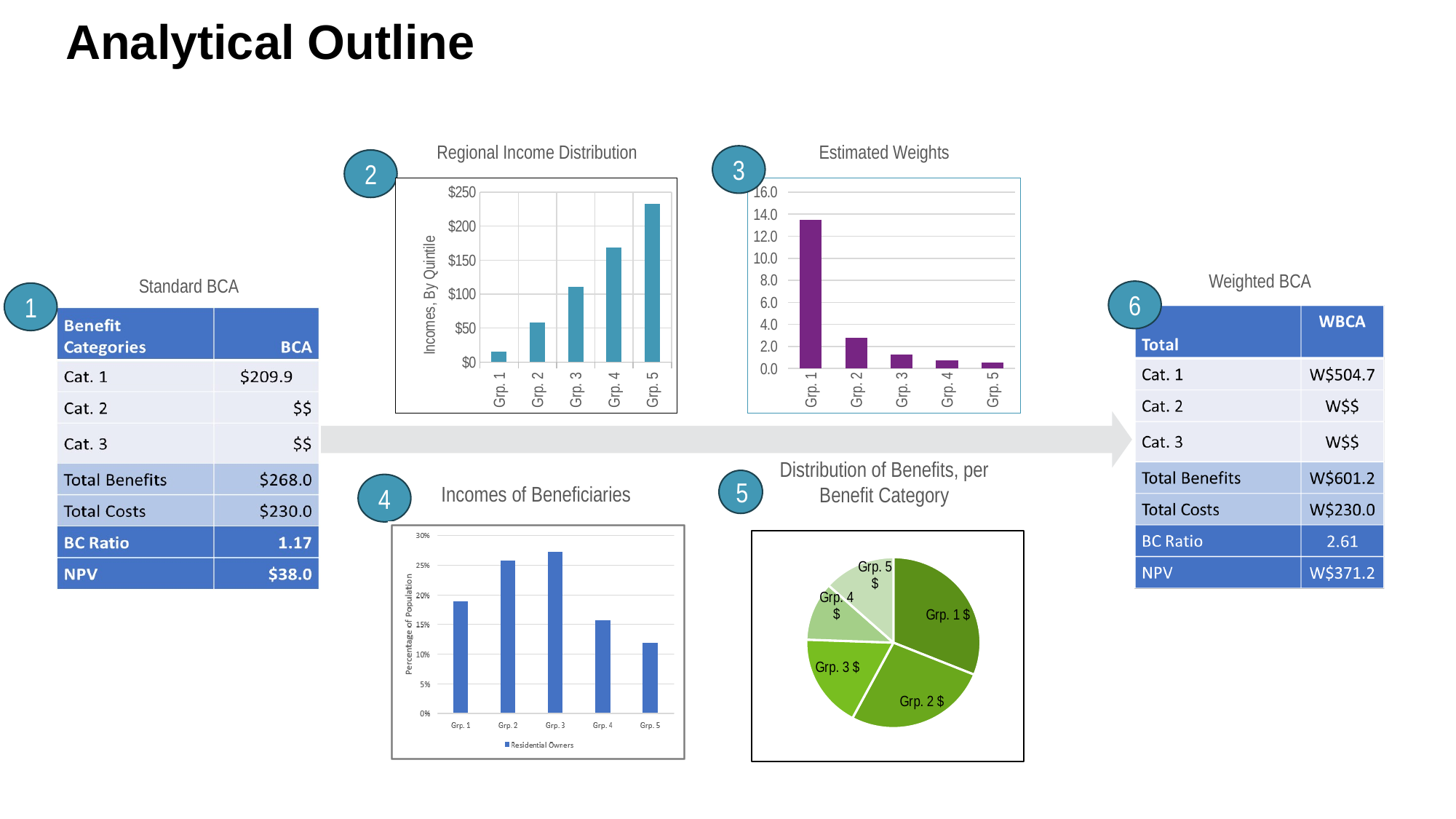
In the Regional Income Distribution chart, is the value for Grp. 5 greater or less than $200? greater In the Regional Income Distribution chart, which group has the highest income? Grp. 5 In the Incomes of Beneficiaries chart, which group has the lowest percentage of population? Grp. 5 How many slices does the Distribution of Benefits, per Benefit Category pie chart have? 5 In the Distribution of Benefits, per Benefit Category pie chart, which slice is the largest? Grp. 1 $ In the Estimated Weights chart, which group has the highest weight? Grp. 1 In the Estimated Weights chart, do the values rise or fall from Grp. 1 to Grp. 5? fall In the Regional Income Distribution chart, is the value for Grp. 1 greater or less than $50? less In the Regional Income Distribution chart, do incomes rise or fall from Grp. 1 to Grp. 5? rise In the Incomes of Beneficiaries chart, is the value for Grp. 1 or Grp. 4 larger? Grp. 1 In the Incomes of Beneficiaries chart, what series does the legend list? Residential Owners In the Estimated Weights chart, is the value for Grp. 1 greater or less than 12.0? greater